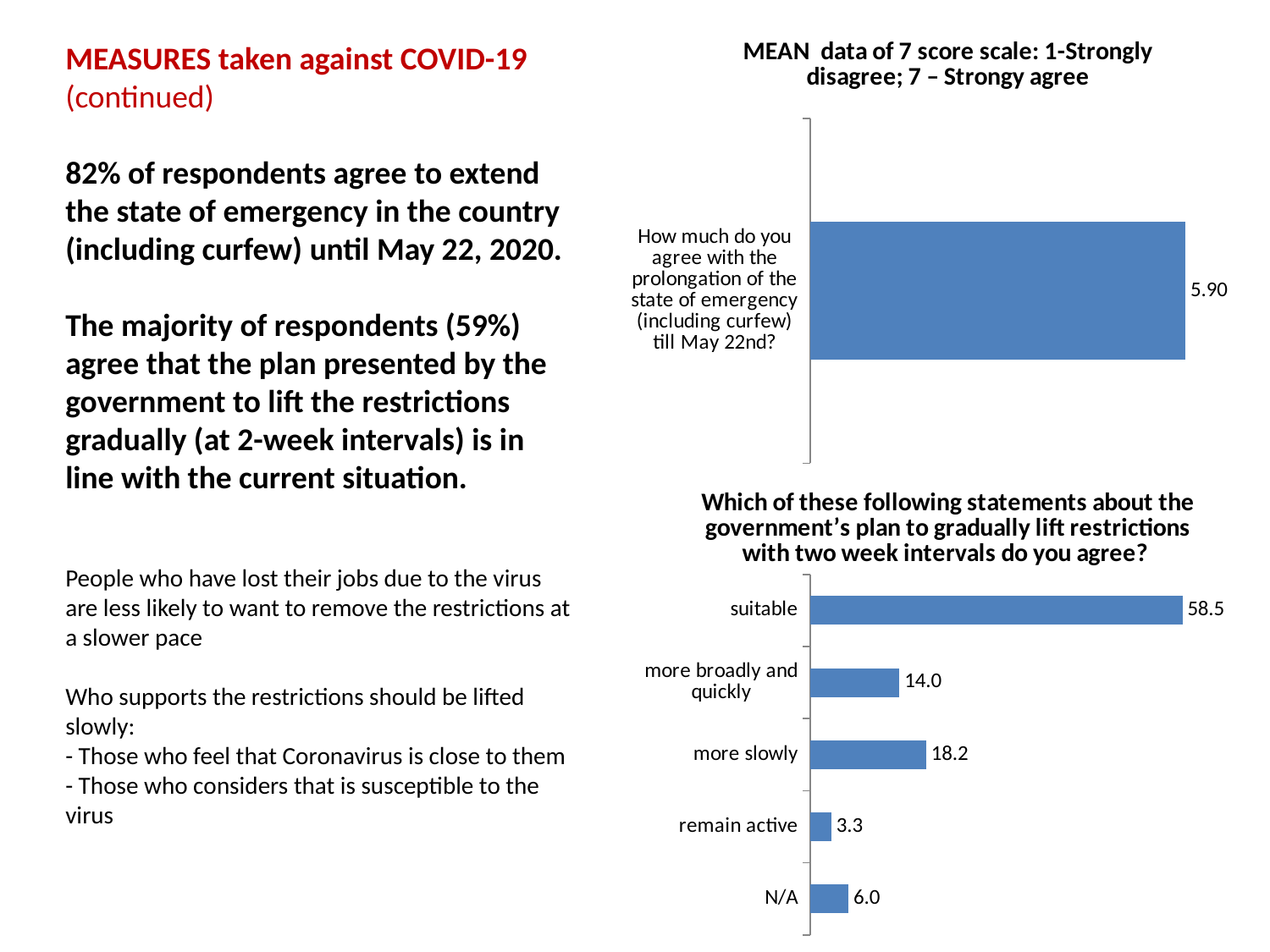
In the bottom chart about the government's plan to gradually lift restrictions, which is larger: 'N/A' or 'remain active'? N/A In the bottom chart about the government's plan to gradually lift restrictions, which category has the highest value? suitable In the bottom chart about the government's plan to gradually lift restrictions, how many categories are shown? 5 What type of chart is the bottom chart about the government's plan to gradually lift restrictions? bar chart In the bottom chart about the government's plan to gradually lift restrictions, what is the value for 'more slowly'? 18.2 In the top chart titled 'MEAN data of 7 score scale', how many bars are plotted? 1 In the top chart titled 'MEAN data of 7 score scale', what is the mean value for 'How much do you agree with the prolongation of the state of emergency (including curfew) till May 22nd?' 5.90 In the bottom chart about the government's plan to gradually lift restrictions, what is the value for 'suitable'? 58.5 In the bottom chart about the government's plan to gradually lift restrictions, what is the difference between 'more slowly' and 'more broadly and quickly'? 4.2 In the bottom chart about the government's plan to gradually lift restrictions, which category has the lowest value? remain active What type of chart is the top chart titled 'MEAN data of 7 score scale'? bar chart In the bottom chart about the government's plan to gradually lift restrictions, what is the value for 'remain active'? 3.3